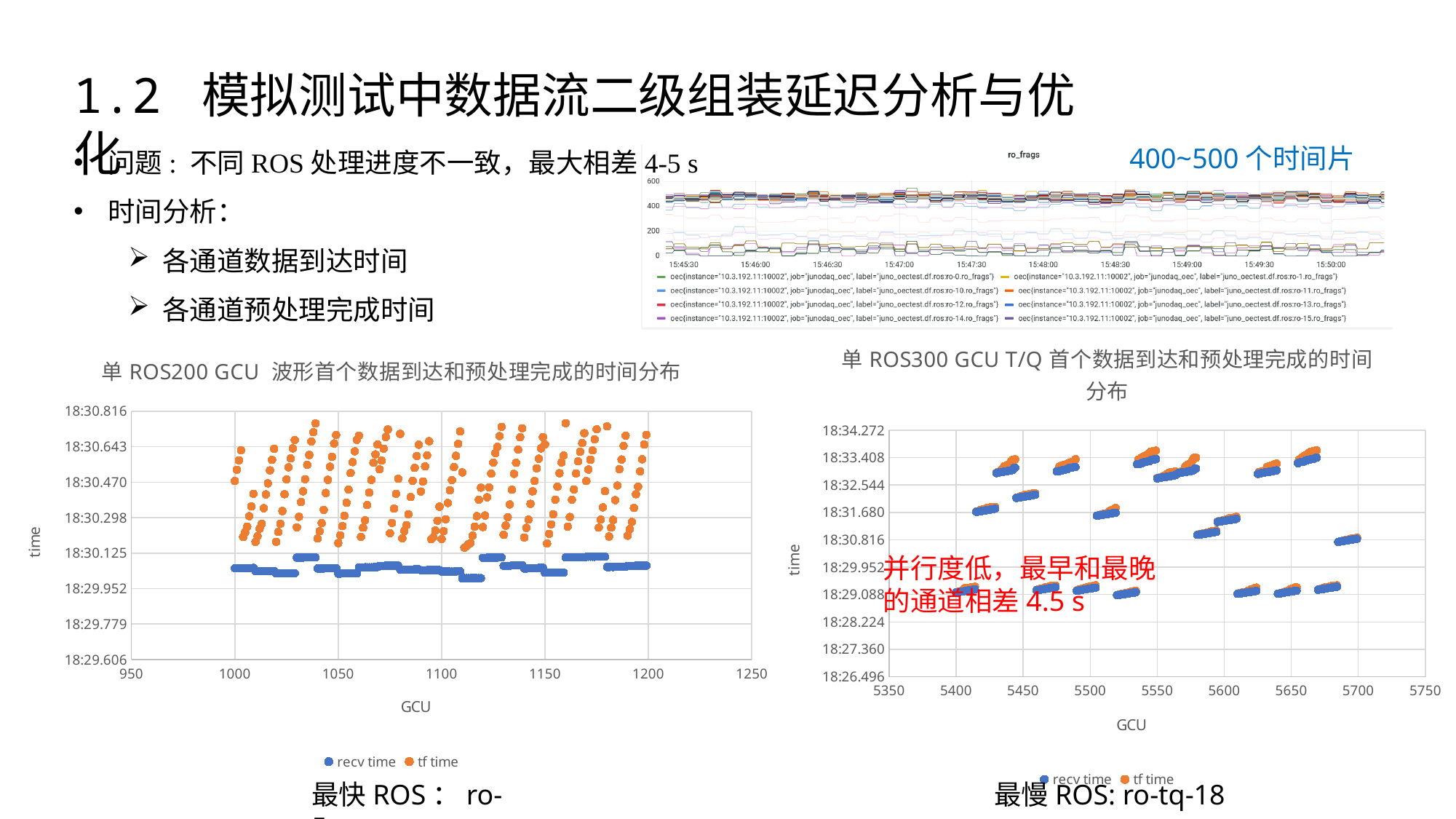
In the bottom-left chart (单 ROS200 GCU), are the recv time values greater or less than 18:30.298? less How many series does the legend of the bottom-right chart (单 ROS300 GCU T/Q) list? 2 What kind of chart is the bottom-right chart titled 单 ROS300 GCU T/Q 首个数据到达和预处理完成的时间分布? scatter chart How many series does the legend of the top-right ro_frags chart list? 8 What is the title of the line chart at the top right of the slide? ro_frags In the bottom-right chart (单 ROS300 GCU T/Q), are the points at GCU around 5700 greater or less than 18:31.680? less In the bottom-left chart (单 ROS200 GCU), are the tf time values greater or less than 18:30.125? greater What are the two legend entries of the bottom-left chart (单 ROS200 GCU)? recv time, tf time What kind of chart is the bottom-left chart titled 单 ROS200 GCU 波形首个数据到达和预处理完成的时间分布? scatter chart How many series does the legend of the bottom-left chart (单 ROS200 GCU) list? 2 In the bottom-left chart (单 ROS200 GCU), which series has the higher time values, recv time or tf time? tf time